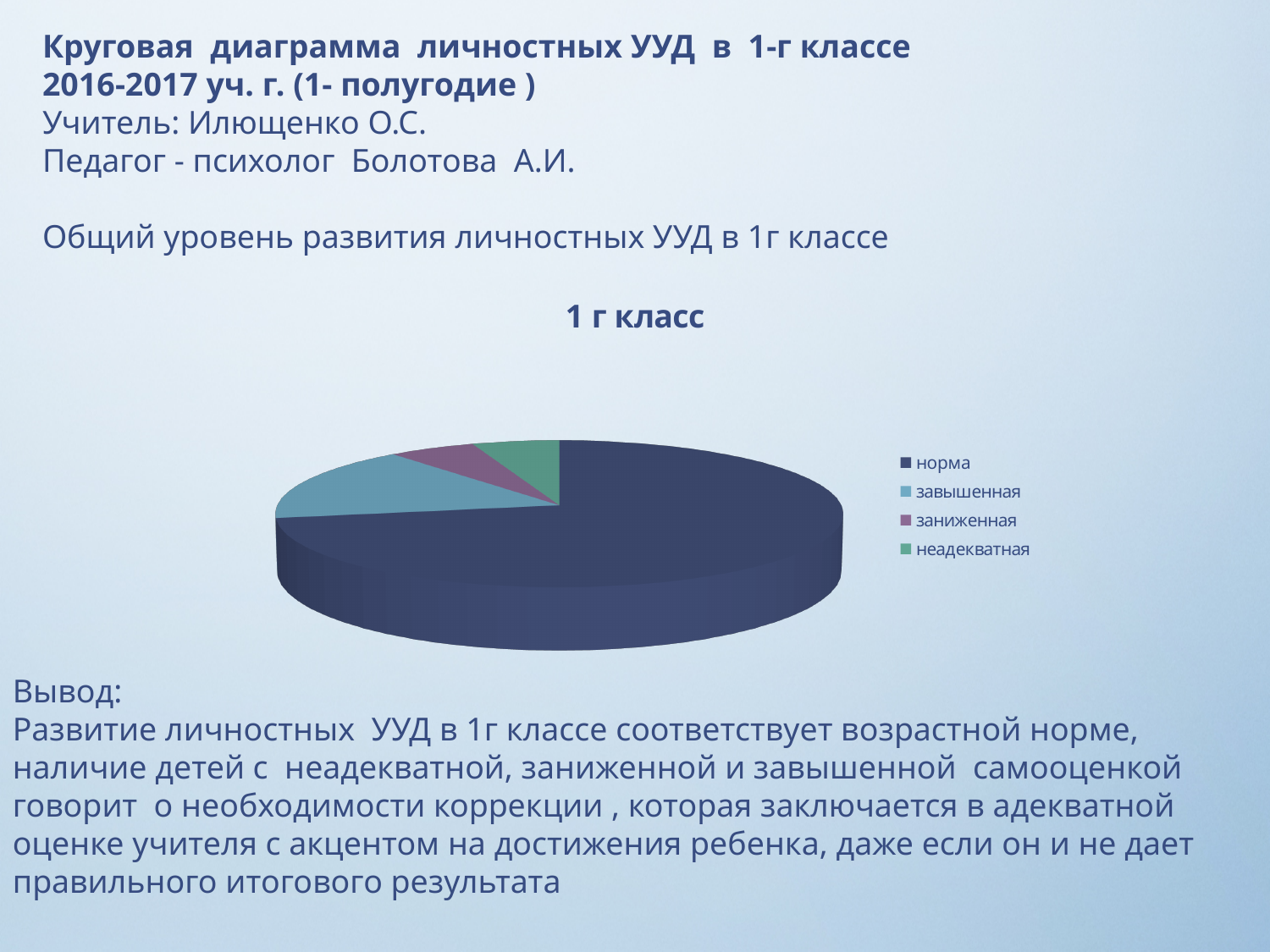
Which category has the largest slice of the pie? норма How many slices does the pie chart have? 4 Which slice is larger, завышенная or неадекватная? завышенная Which slice is larger, норма or завышенная? норма Which slice is larger, завышенная or заниженная? завышенная What kind of chart is shown on the slide? pie chart Does the норма slice take up more or less than half of the pie? more Which category is shown in dark blue on the chart? норма How many categories does the legend of the chart list? 4 What is the title of the chart? 1 г класс